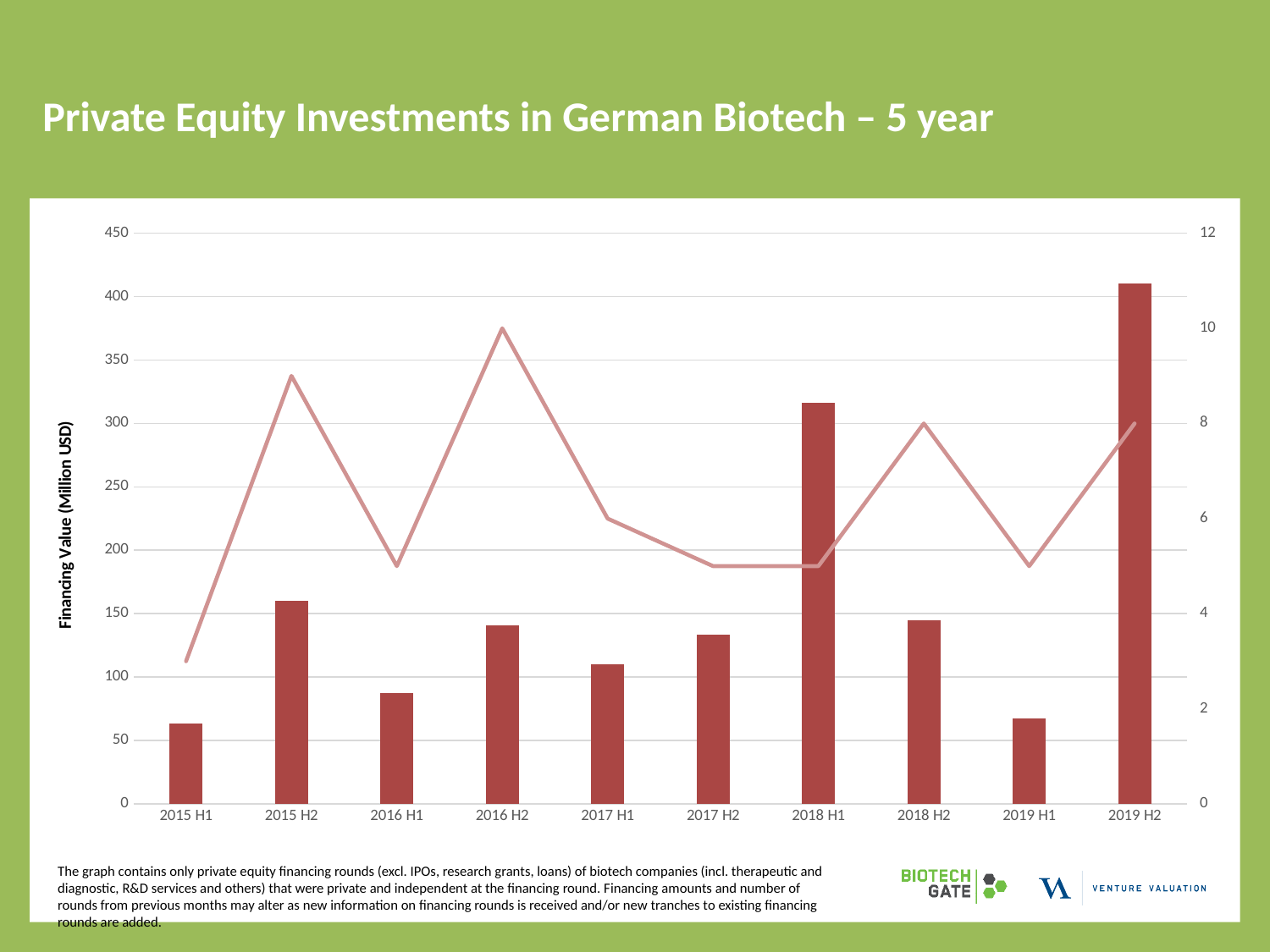
What kind of chart is shown on the slide? A combined bar and line chart Is the financing value bar for 2016 H1 greater or less than 100? less At which period does the line series reach its highest point on the right-hand axis? 2016 H2 What is the title of the chart on this slide? Private Equity Investments in German Biotech – 5 year Is the financing value bar for 2019 H1 greater or less than 100? less How many half-year periods are shown on the x axis? 10 What value on the right-hand axis does the line series reach at 2016 H2? 10 Is the financing value bar for 2017 H2 greater or less than 150? less Which bar is taller, 2018 H1 or 2018 H2? 2018 H1 Which period has the tallest bar for financing value? 2019 H2 What is the label of the left vertical axis? Financing Value (Million USD)